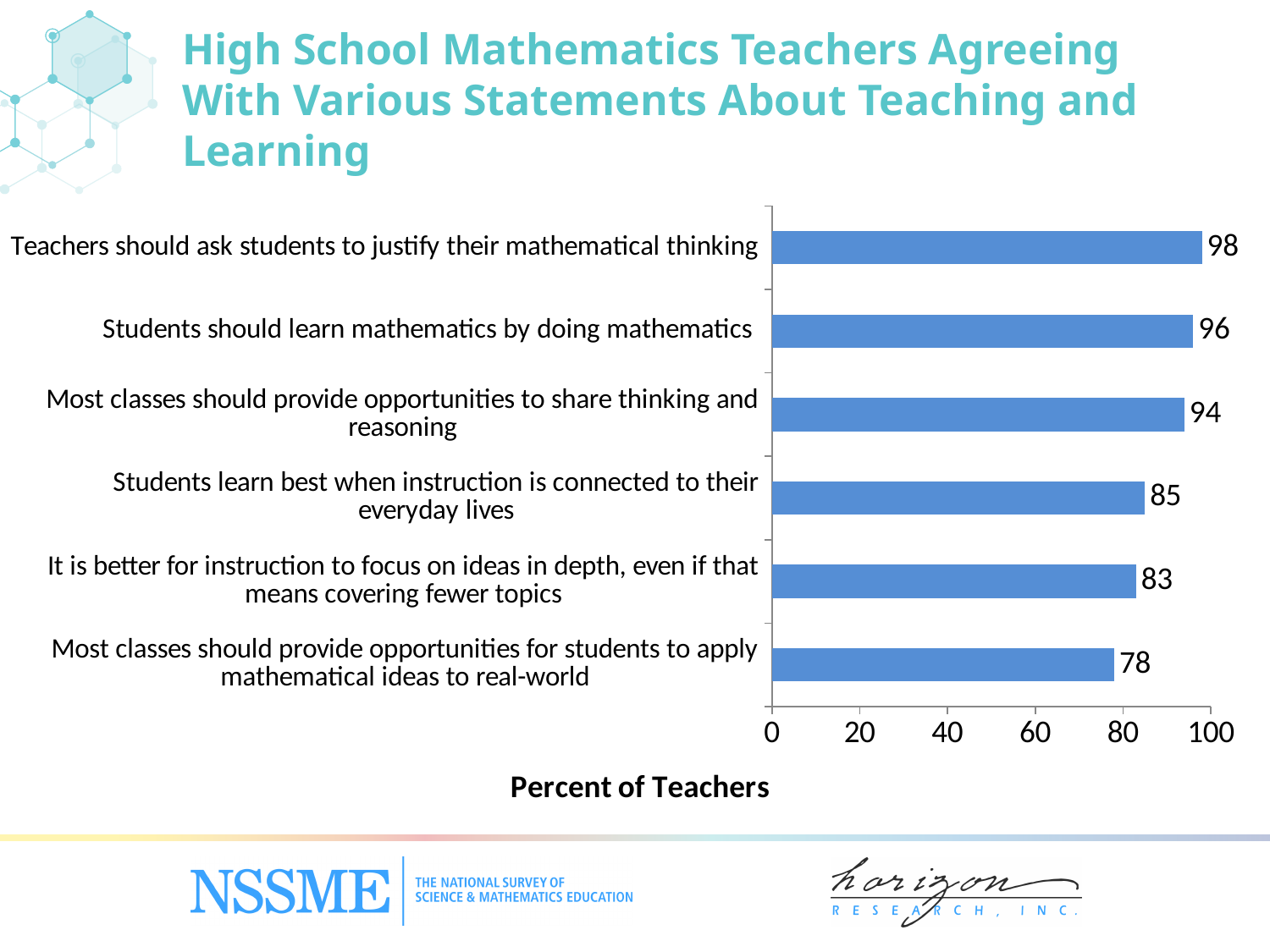
What kind of chart is shown on the slide? Bar chart What percent of teachers agree that students learn best when instruction is connected to their everyday lives? 85 How many statements are shown in the chart? 6 Which has a higher percent of teachers agreeing: 'Students learn best when instruction is connected to their everyday lives' or 'It is better for instruction to focus on ideas in depth, even if that means covering fewer topics'? Students learn best when instruction is connected to their everyday lives What is the difference in percent of teachers between 'Teachers should ask students to justify their mathematical thinking' and 'Most classes should provide opportunities for students to apply mathematical ideas to real-world'? 20 What percent of teachers agree that most classes should provide opportunities for students to apply mathematical ideas to real-world? 78 What is the difference in percent of teachers between 'Most classes should provide opportunities to share thinking and reasoning' and 'It is better for instruction to focus on ideas in depth, even if that means covering fewer topics'? 11 What is the label of the horizontal axis? Percent of Teachers What percent of teachers agree that students should learn mathematics by doing mathematics? 96 Which statement has the highest percent of teachers agreeing? Teachers should ask students to justify their mathematical thinking Which statement has the lowest percent of teachers agreeing? Most classes should provide opportunities for students to apply mathematical ideas to real-world What percent of teachers agree that teachers should ask students to justify their mathematical thinking? 98